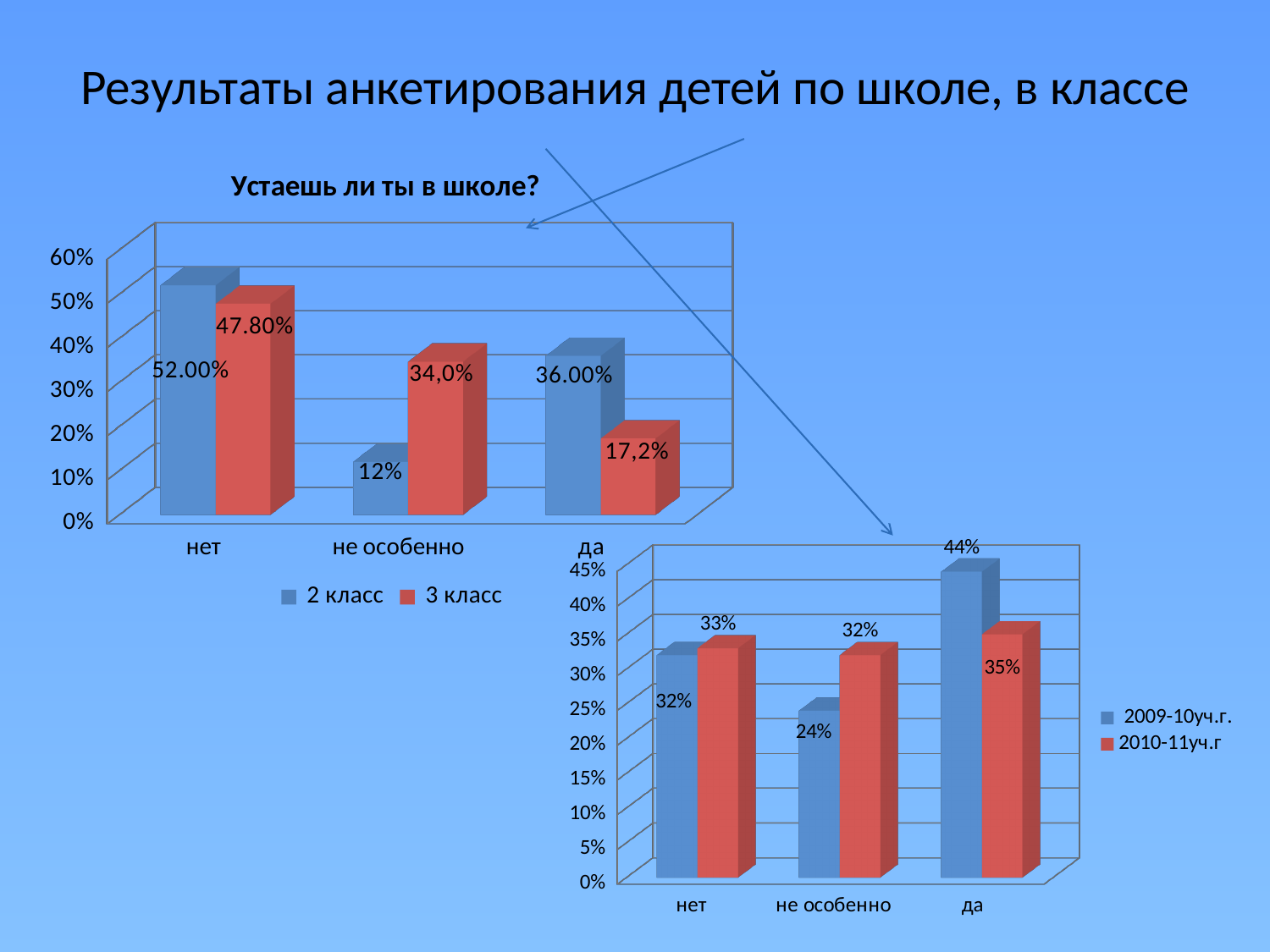
In the chart at the bottom right of the slide, how many categories are shown on the x axis? 3 In the chart titled "Устаешь ли ты в школе?", what is the value for "2 класс" in the "нет" category? 52.00% What kind of chart is the chart titled "Устаешь ли ты в школе?"? bar chart In the chart at the bottom right of the slide, what is the value for "2009-10уч.г." in the "да" category? 44% In the chart titled "Устаешь ли ты в школе?", which category has the lowest value for "2 класс"? не особенно In the chart at the bottom right of the slide, what is the difference between the "2009-10уч.г." and "2010-11уч.г" values in the "да" category? 9% In the chart at the bottom right of the slide, which category has the highest value for "2009-10уч.г."? да In the chart titled "Устаешь ли ты в школе?", how many series does the legend list? 2 In the chart titled "Устаешь ли ты в школе?", what is the value for "3 класс" in the "да" category? 17,2% In the chart titled "Устаешь ли ты в школе?", what is the value for "3 класс" in the "не особенно" category? 34,0% In the chart at the bottom right of the slide, what is the value for "2010-11уч.г" in the "не особенно" category? 32% In the chart titled "Устаешь ли ты в школе?", which is larger in the "да" category: "2 класс" or "3 класс"? 2 класс